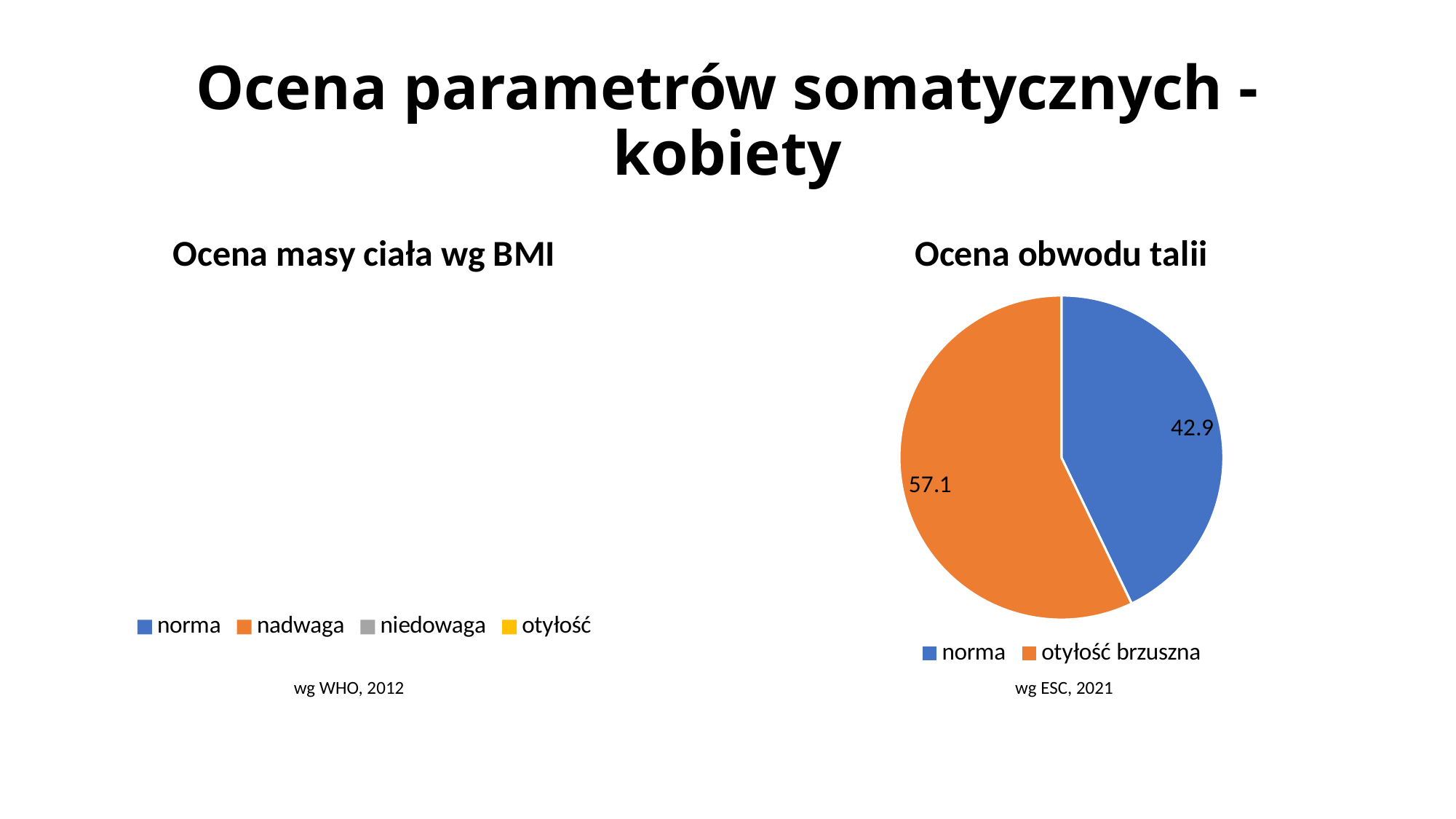
In the 'Ocena obwodu talii' chart, what is the difference between the values for 'otyłość brzuszna' and 'norma'? 14.2 How many entries does the legend of the 'Ocena masy ciała wg BMI' chart list? 4 In the 'Ocena obwodu talii' chart, what colour is the 'otyłość brzuszna' slice? orange What type of chart is 'Ocena obwodu talii'? pie chart How many slices does the 'Ocena obwodu talii' chart have? 2 In the 'Ocena obwodu talii' chart, what value is shown for 'otyłość brzuszna'? 57.1 What source note is printed below the 'Ocena obwodu talii' chart? wg ESC, 2021 In the 'Ocena obwodu talii' chart, what value is shown for 'norma'? 42.9 In the 'Ocena obwodu talii' chart, which is larger: 'norma' or 'otyłość brzuszna'? otyłość brzuszna In the 'Ocena obwodu talii' chart, which category has the largest slice? otyłość brzuszna In the 'Ocena obwodu talii' chart, which category has the smallest slice? norma In the 'Ocena obwodu talii' chart, what share of the pie does 'norma' represent? 42.9